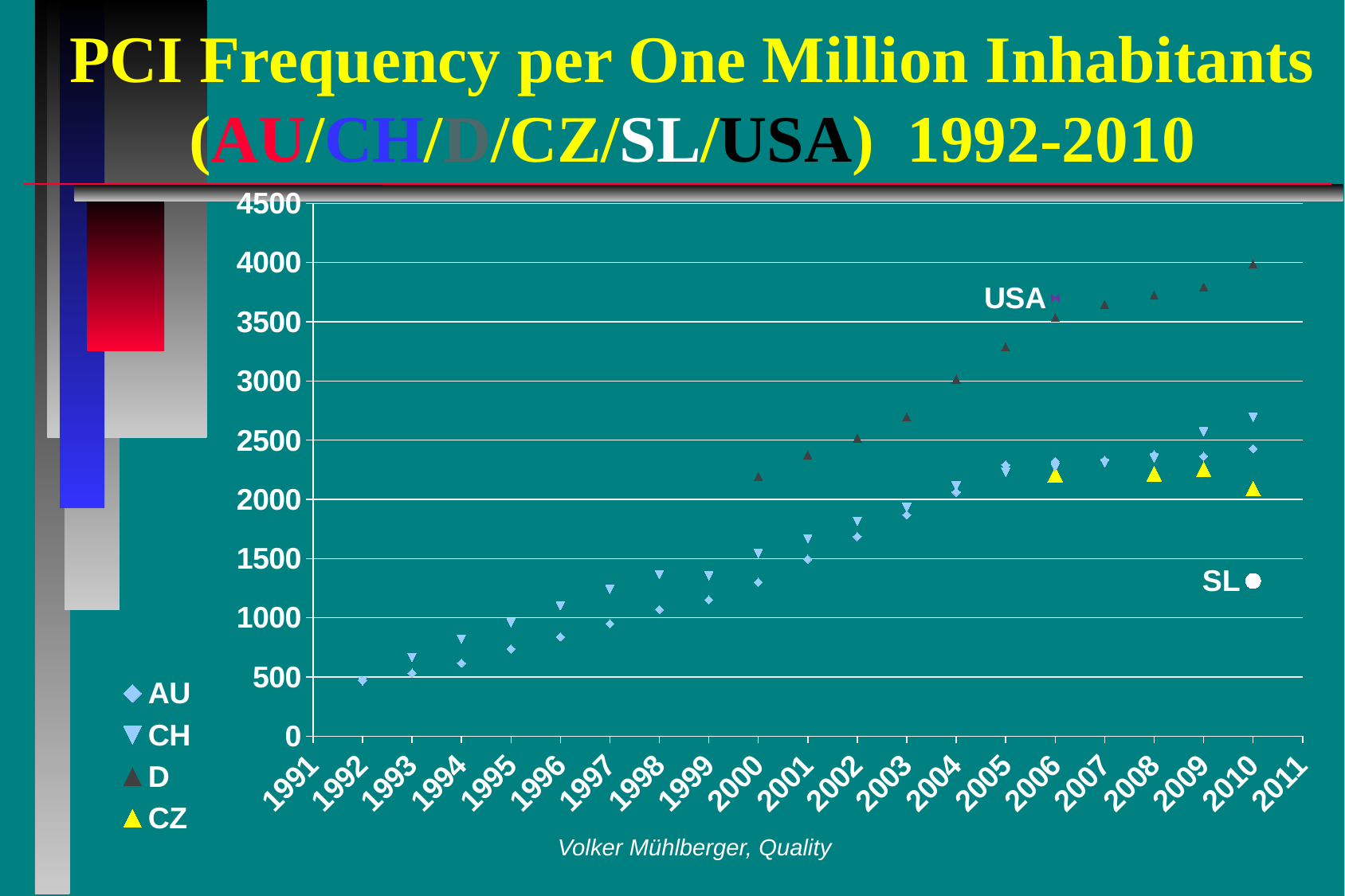
Is the value for D in 2005 greater or less than 3000? greater How many series does the chart legend list? 4 Which series has the highest value in 2010? D Is the value for CH in 2010 greater or less than 2500? greater Do the values for D rise or fall from 2000 to 2010? rise What kind of chart is shown on the slide? scatter chart Which series has the lowest value in 2010? SL Which is larger in 2010, the value for D or the value for CZ? D Is the value for AU in 1992 greater or less than 1000? less What is the title of the chart? PCI Frequency per One Million Inhabitants (AU/CH/D/CZ/SL/USA) 1992-2010